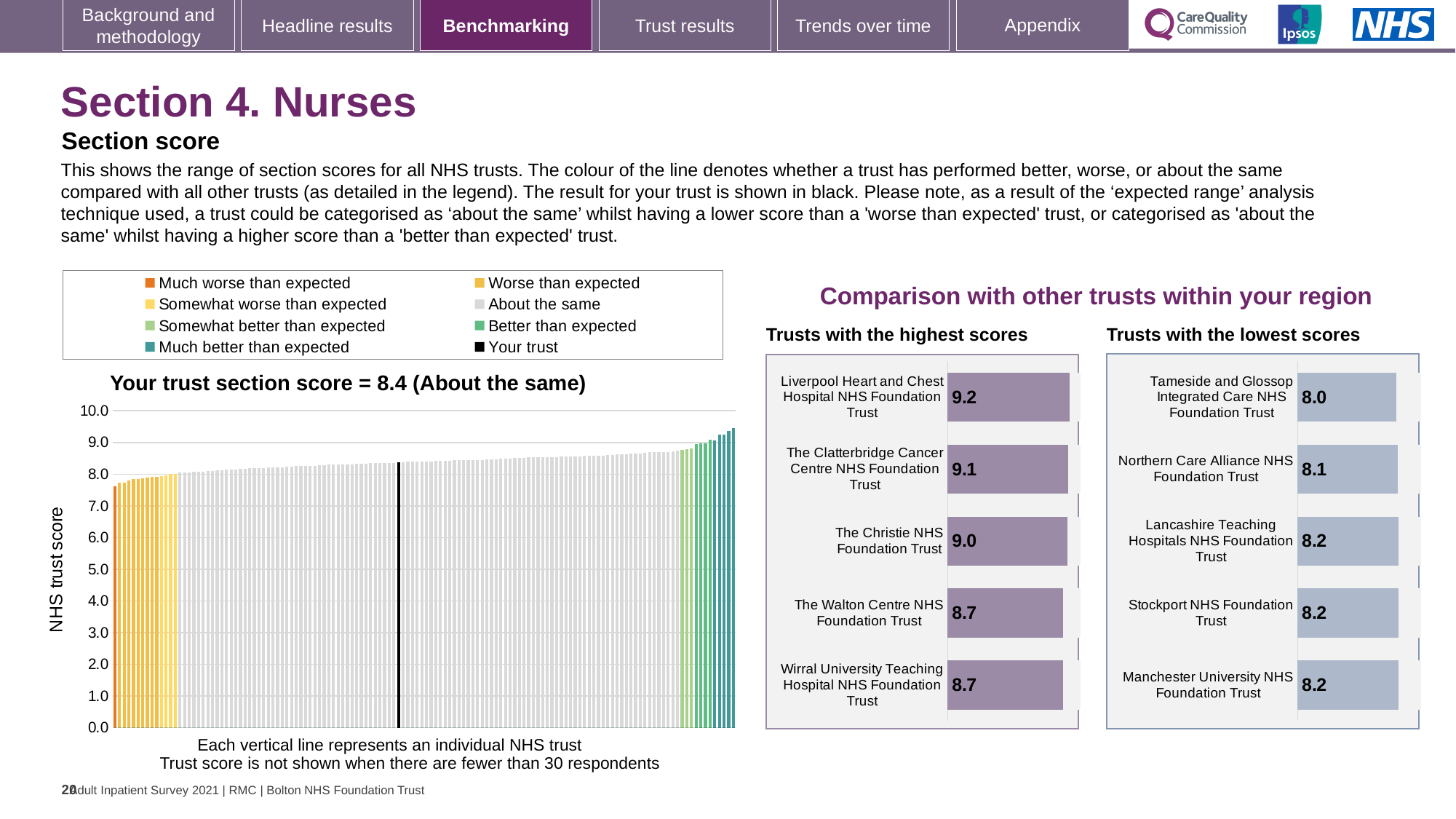
In the 'Trusts with the highest scores' chart, what is the score for The Christie NHS Foundation Trust? 9.0 In the 'Trusts with the lowest scores' chart, which trust has the lowest score? Tameside and Glossop Integrated Care NHS Foundation Trust What kind of chart is the 'Trusts with the highest scores' chart? bar chart In the main 'NHS trust score' chart, what is your trust's section score as stated in the chart title? 8.4 In the 'Trusts with the highest scores' chart, which trust has the highest score? Liverpool Heart and Chest Hospital NHS Foundation Trust In the main 'NHS trust score' chart, do the values rise or fall from left to right along the x axis? rise In the 'Trusts with the highest scores' chart, what is the score for Liverpool Heart and Chest Hospital NHS Foundation Trust? 9.2 In the 'Trusts with the highest scores' chart, what is the difference between the scores of Liverpool Heart and Chest Hospital NHS Foundation Trust and The Christie NHS Foundation Trust? 0.2 How many entries does the legend of the main 'NHS trust score' chart list? 8 In the 'Trusts with the lowest scores' chart, what is the score for Northern Care Alliance NHS Foundation Trust? 8.1 Which is larger: the score for The Walton Centre NHS Foundation Trust in the highest scores chart, or the score for Stockport NHS Foundation Trust in the lowest scores chart? The Walton Centre NHS Foundation Trust How many trusts are shown in the 'Trusts with the lowest scores' chart? 5